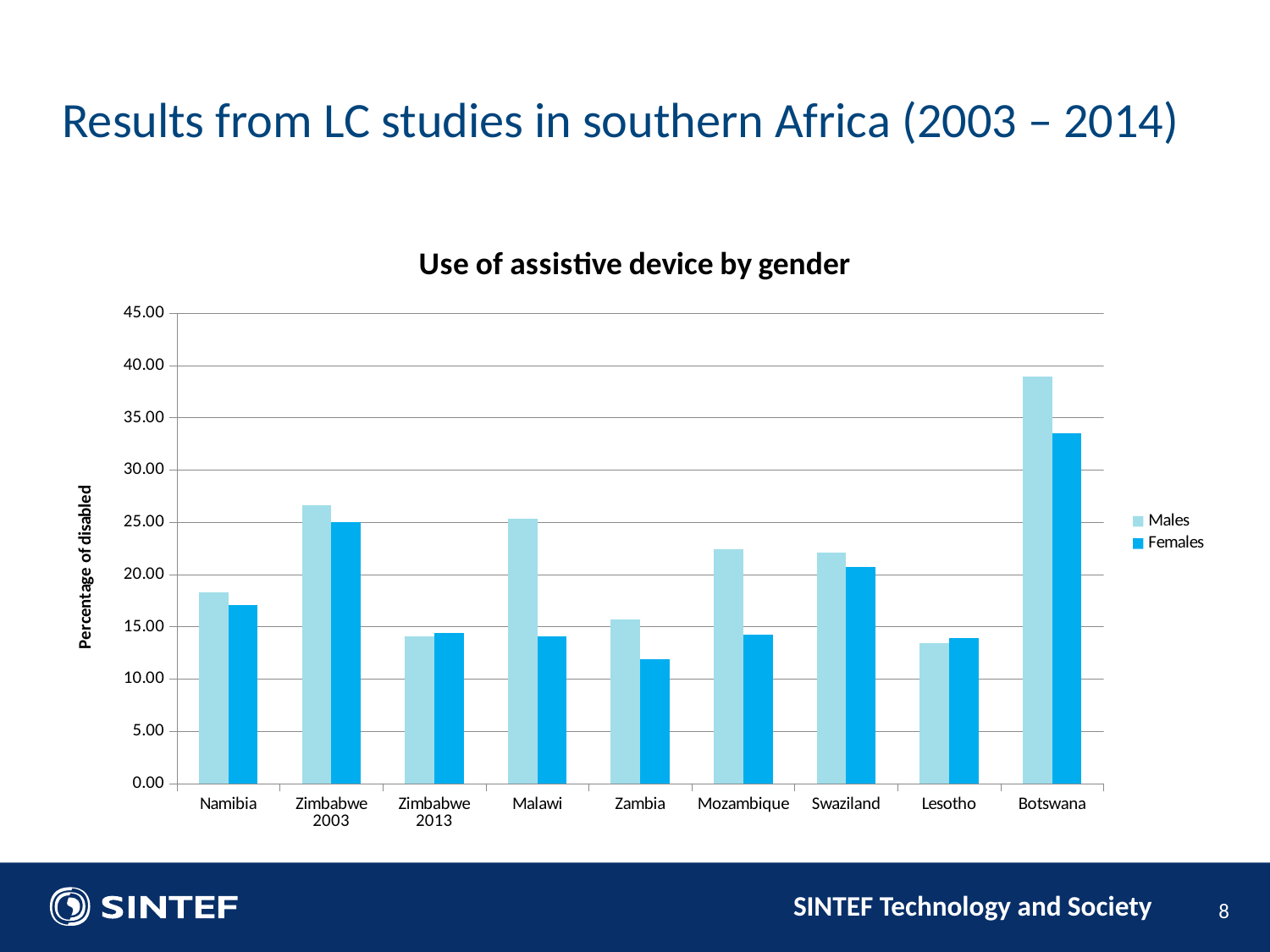
In Malawi, which is larger, the value for Males or the value for Females? Males What is the label on the vertical axis of the chart? Percentage of disabled What is the title of the chart? Use of assistive device by gender What kind of chart is shown on the slide? bar chart Which category has the lowest value for Females? Zambia Is the value for Females in Zambia greater or less than 15.00? less Is the value for Males in Namibia greater or less than 20.00? less How many series does the legend list? 2 How many categories are shown along the x axis? 9 Which category has the highest value for Females? Botswana Which category has the highest value for Males? Botswana Is the value for Males in Botswana greater or less than 35.00? greater